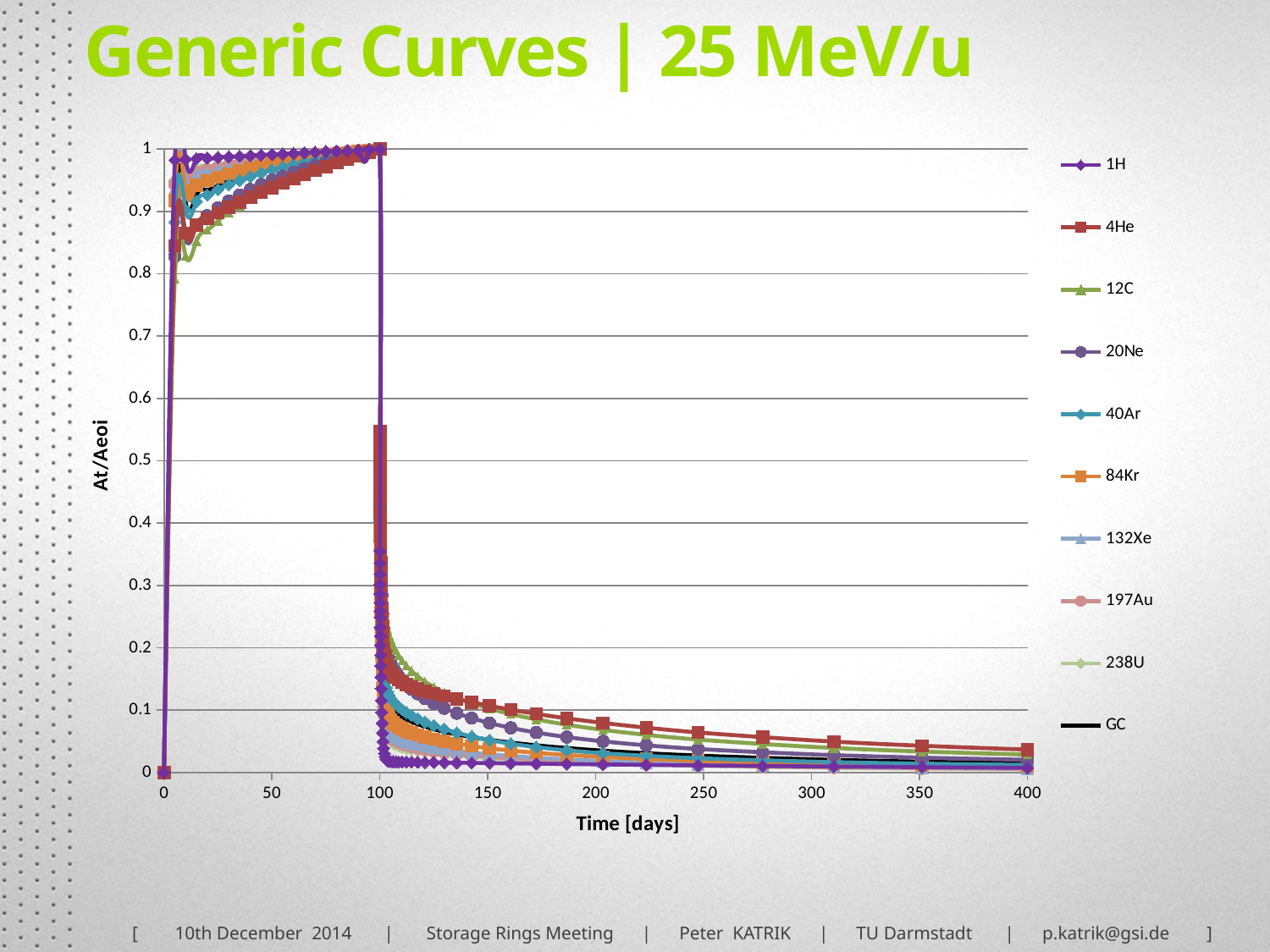
Do the curves rise or fall along the x axis between 20 and 100 days? rise How many series does the legend list? 10 Do the curves rise or fall along the x axis between 100 and 400 days? fall What kind of chart is shown on the slide? line chart Is the value for 4He at 50 days greater or less than 0.8? greater Is the value for 4He at 250 days greater or less than 0.1? less Which series is highest in the region between 150 and 400 days? 4He What is the title of the chart on the slide? Generic Curves | 25 MeV/u At 300 days, which is larger, the value for 4He or the value for 1H? 4He Is the value for 1H at 200 days greater or less than 0.1? less What is the label of the x axis? Time [days]